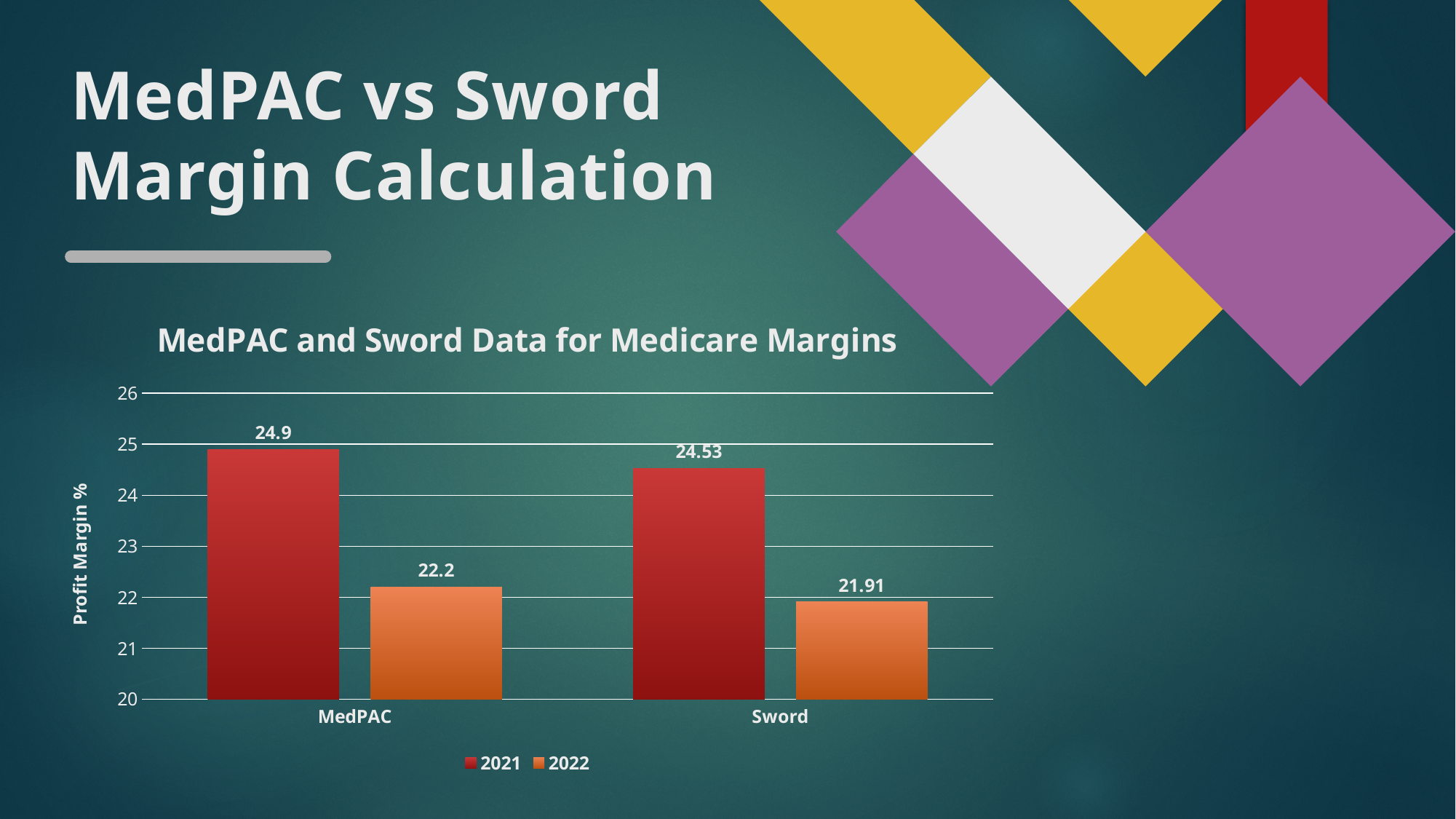
How many series does the legend list? 2 What is the difference between the 2021 and 2022 values for MedPAC? 2.7 What is the 2022 value for MedPAC? 22.2 Which category has the lowest 2022 value? Sword What is the title of the chart? MedPAC and Sword Data for Medicare Margins What is the 2022 value for Sword? 21.91 What kind of chart is shown on the slide? Bar chart What is the 2021 value for Sword? 24.53 What is the difference between the 2021 and 2022 values for Sword? 2.62 What is the 2021 value for MedPAC? 24.9 Which is larger, the 2022 value for MedPAC or the 2022 value for Sword? MedPAC Which category has the highest 2021 value? MedPAC